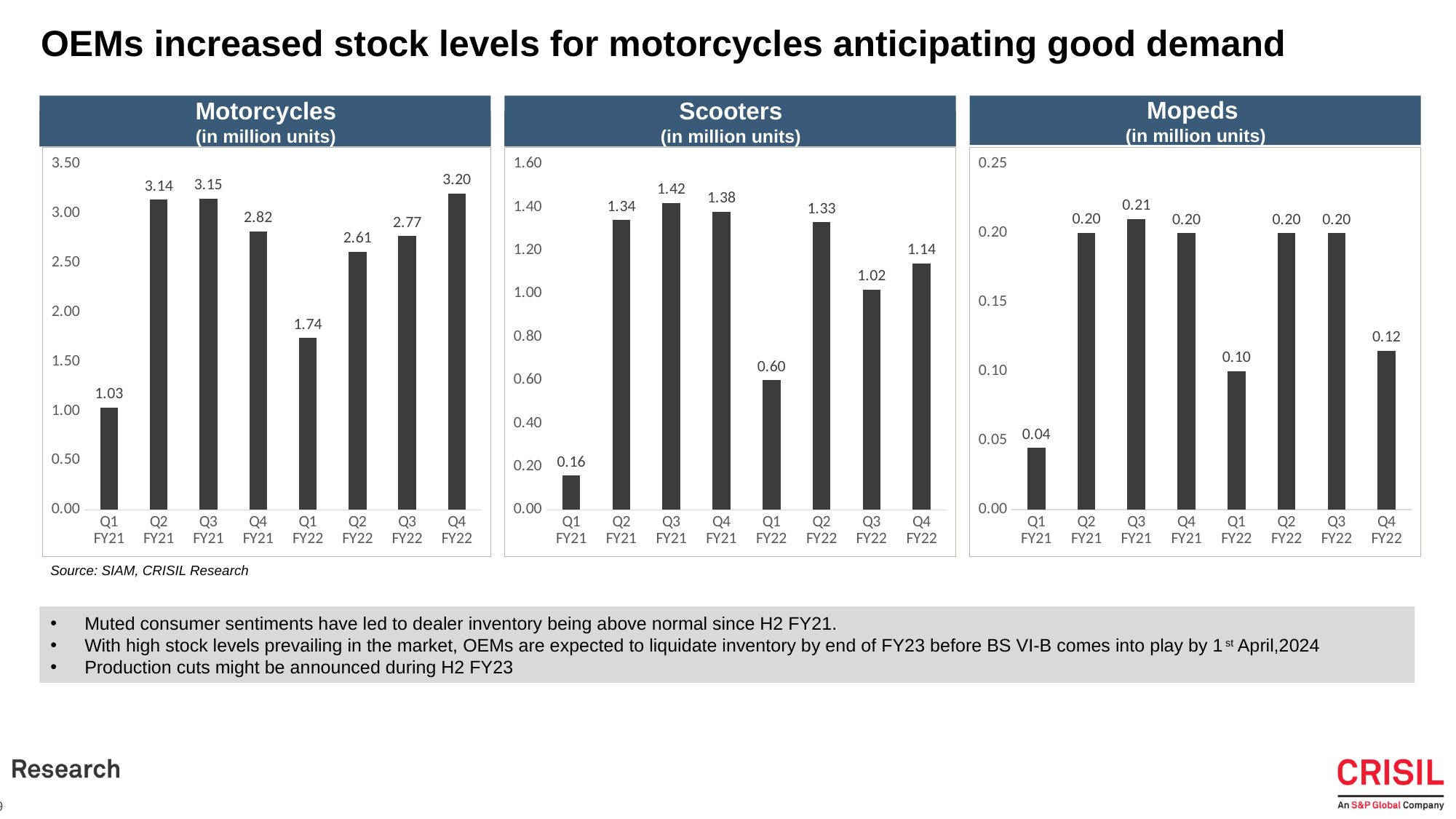
In the Mopeds chart, what is the value for Q4 FY22? 0.12 In the Scooters chart, which is larger, Q2 FY22 or Q4 FY22? Q2 FY22 In the Motorcycles chart, which quarter has the lowest value? Q1 FY21 In the Motorcycles chart, which quarter has the highest value? Q4 FY22 In the Motorcycles chart, what is the difference between Q4 FY22 and Q1 FY21? 2.17 In the Mopeds chart, which quarter has the highest value? Q3 FY21 In the Scooters chart, which quarter has the lowest value? Q1 FY21 What type of chart is the Scooters chart? Bar chart How many bars are in the Mopeds chart? 8 In the Scooters chart, what is the value for Q3 FY21? 1.42 In the Scooters chart, what is the difference between Q2 FY22 and Q1 FY22? 0.73 In the Motorcycles chart, what is the value for Q1 FY22? 1.74